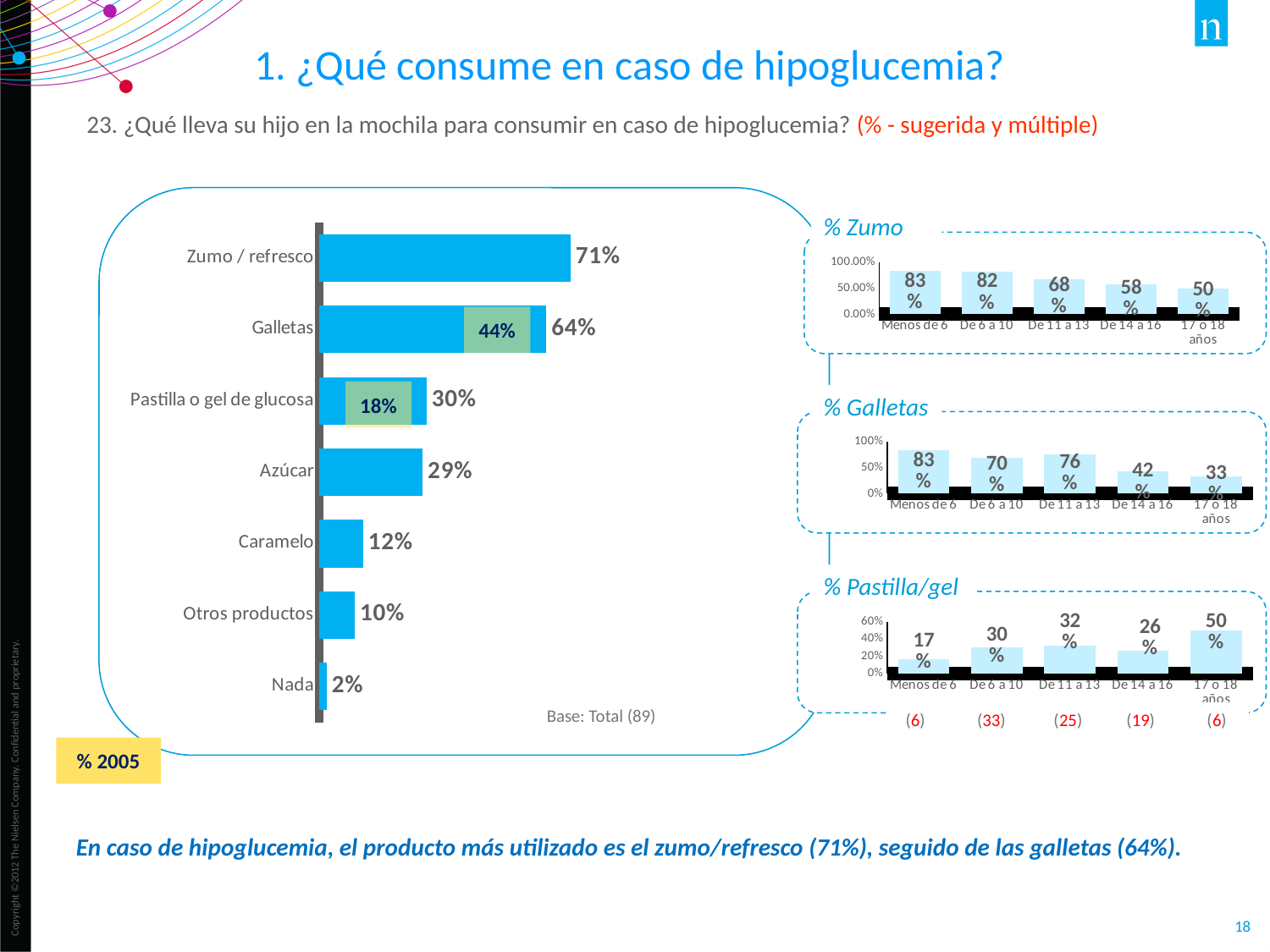
In the main bar chart on the left, what is the difference between Galletas and Pastilla o gel de glucosa? 34% In the % Pastilla/gel chart, which age group has the lowest value? Menos de 6 In the % Pastilla/gel chart, what is the value for 17 o 18 años? 50% In the % Zumo chart, what is the value for De 14 a 16? 58% In the main bar chart on the left, which category has the lowest value? Nada In the % Galletas chart, which is larger: De 6 a 10 or De 11 a 13? De 11 a 13 In the % Galletas chart, which age group has the highest value? Menos de 6 In the % Zumo chart, do the values rise or fall from Menos de 6 to 17 o 18 años? Fall In the main bar chart on the left, what is the value for Zumo / refresco? 71% In the main bar chart on the left, what kind of chart is it? Bar chart In the main bar chart on the left, what was the 2005 value shown for Galletas? 44% In the main bar chart on the left, how many categories are shown? 7